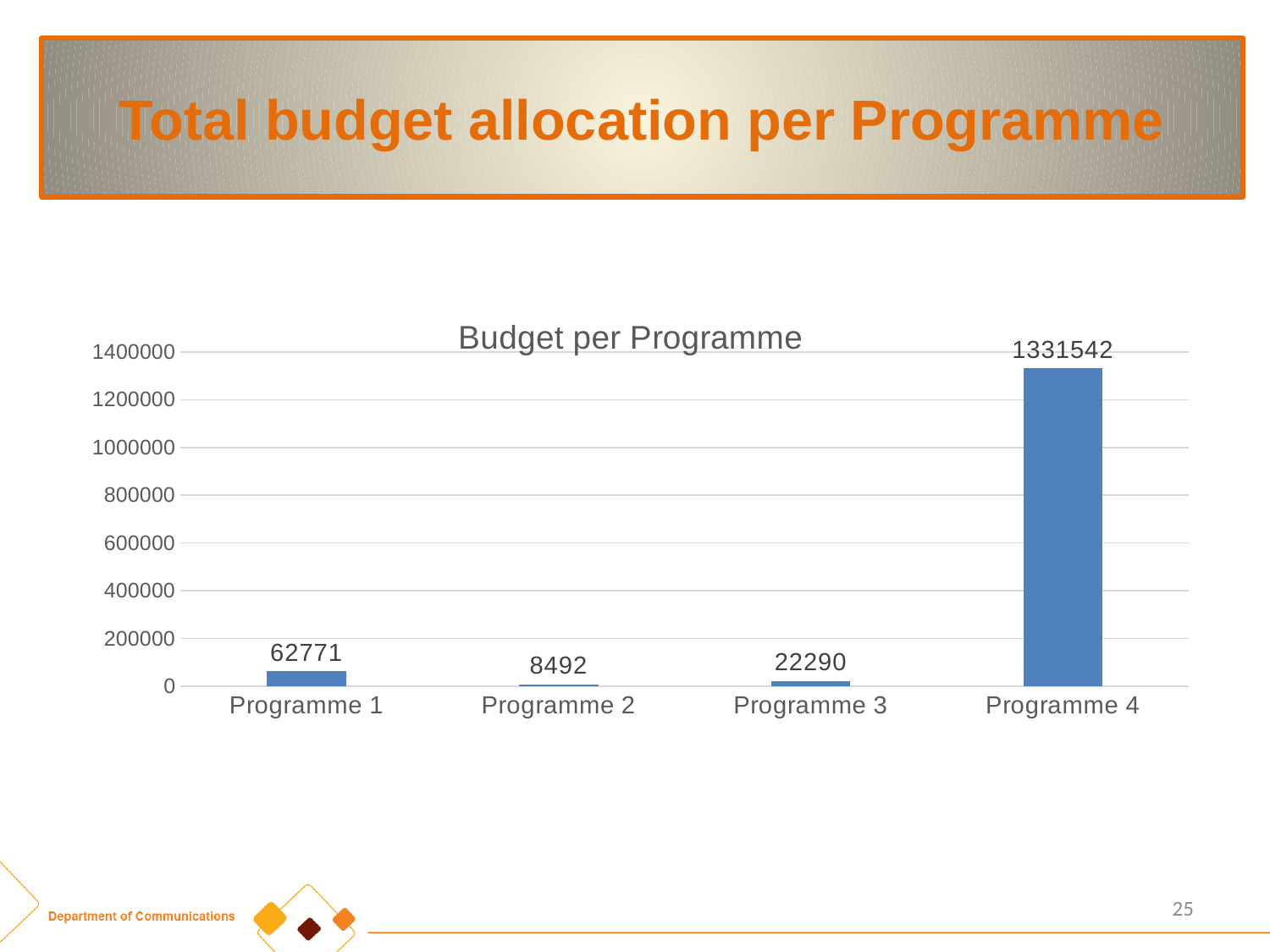
Is the value for Programme 4 greater or less than 1200000? greater What is the difference between the values for Programme 3 and Programme 2? 13798 Which programme has the lowest budget? Programme 2 What is the value for Programme 1? 62771 What is the value for Programme 4? 1331542 Which is larger, the value for Programme 1 or Programme 3? Programme 1 Which programme has the highest budget? Programme 4 How many programmes are shown in the chart? 4 What is the value for Programme 2? 8492 What type of chart is shown on the slide? Bar chart What is the value for Programme 3? 22290 What is the difference between the values for Programme 4 and Programme 1? 1268771